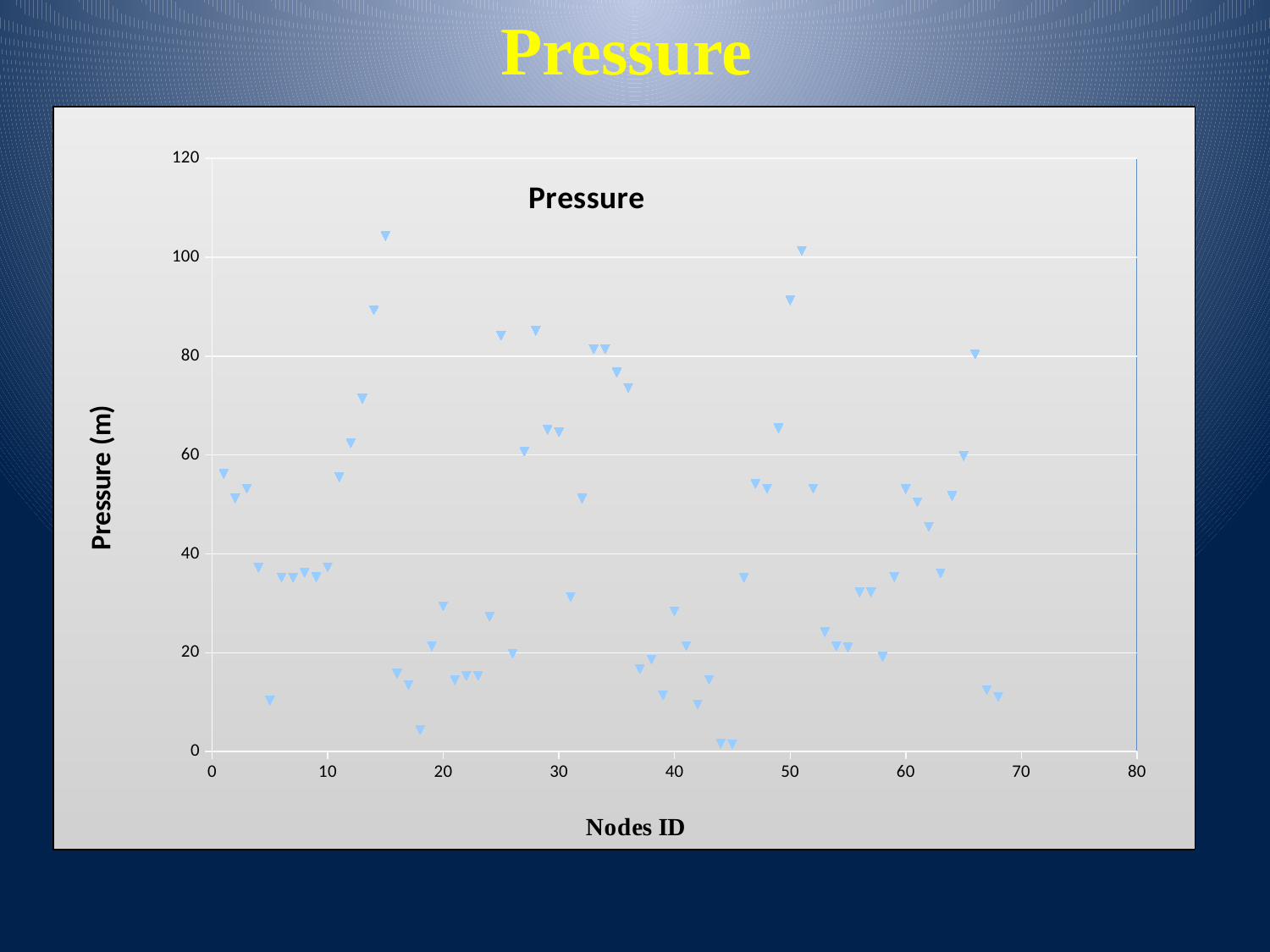
Is the pressure value for node 30 greater or less than 60? greater Is the pressure value for node 40 greater or less than 40? less Is the highest pressure value plotted on the chart greater or less than 100? greater What kind of chart is shown on the slide? scatter chart Which has the higher pressure value, node 30 or node 10? node 30 Which has the higher pressure value, node 50 or node 60? node 50 What is the label of the x axis of the chart? Nodes ID What is the title of the chart? Pressure